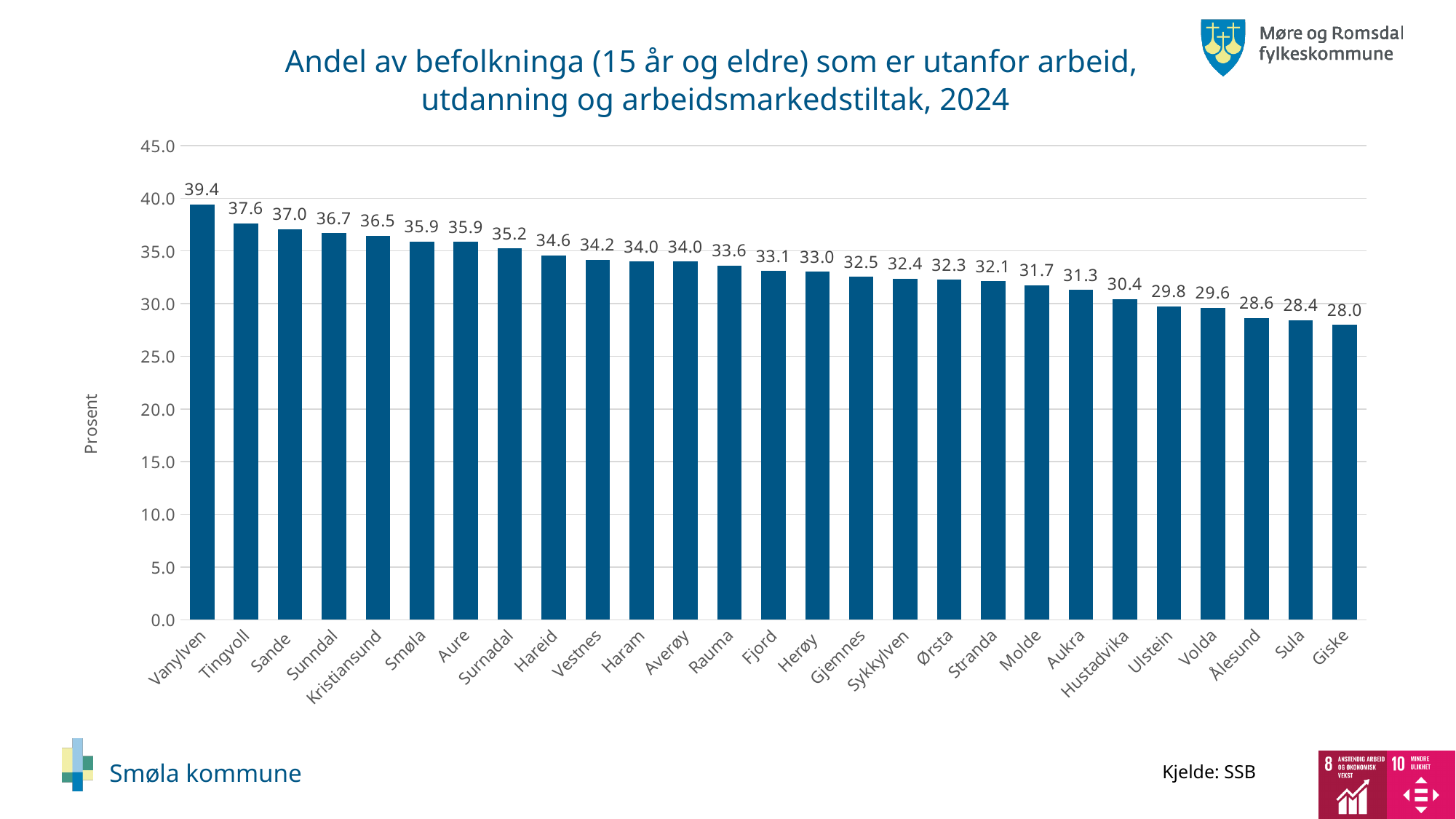
Which municipality has the highest value? Vanylven What is the value for Kristiansund? 36.5 What is the difference between the values for Vanylven and Giske? 11.4 Which has a larger value, Tingvoll or Hustadvika? Tingvoll What is the label of the y axis? Prosent What kind of chart is this? Bar chart What is the difference between the values for Smøla and Ålesund? 7.3 What is the value for Molde? 31.7 Which municipality has the lowest value? Giske What is the value for Smøla? 35.9 How many municipalities are shown on the x axis? 27 Do the values rise or fall from left to right along the x axis? Fall